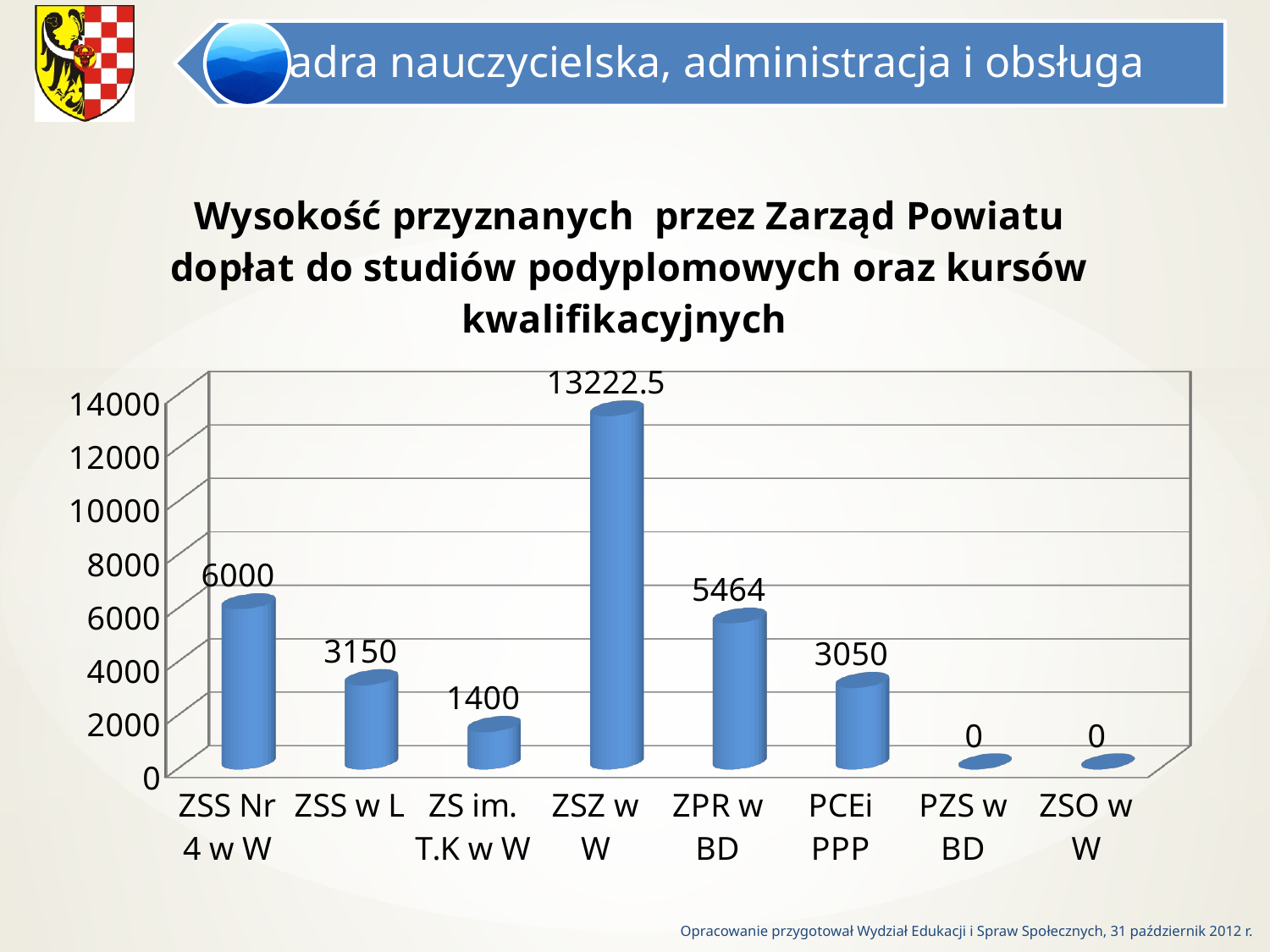
How many categories are shown on the x axis? 8 What is the difference between the values for ZSS Nr 4 w W and ZPR w BD? 536 Is the value for ZSZ w W greater or less than 12000? greater What is the difference between the values for ZSS w L and PCEi PPP? 100 What kind of chart is shown on the slide? bar chart What is the value for ZSZ w W? 13222.5 What is the value for PCEi PPP? 3050 How many categories have a value of 0? 2 Which category has the highest value? ZSZ w W What is the value for ZS im. T.K w W? 1400 What is the value for ZSS Nr 4 w W? 6000 Which is larger, the value for ZPR w BD or the value for ZSS w L? ZPR w BD